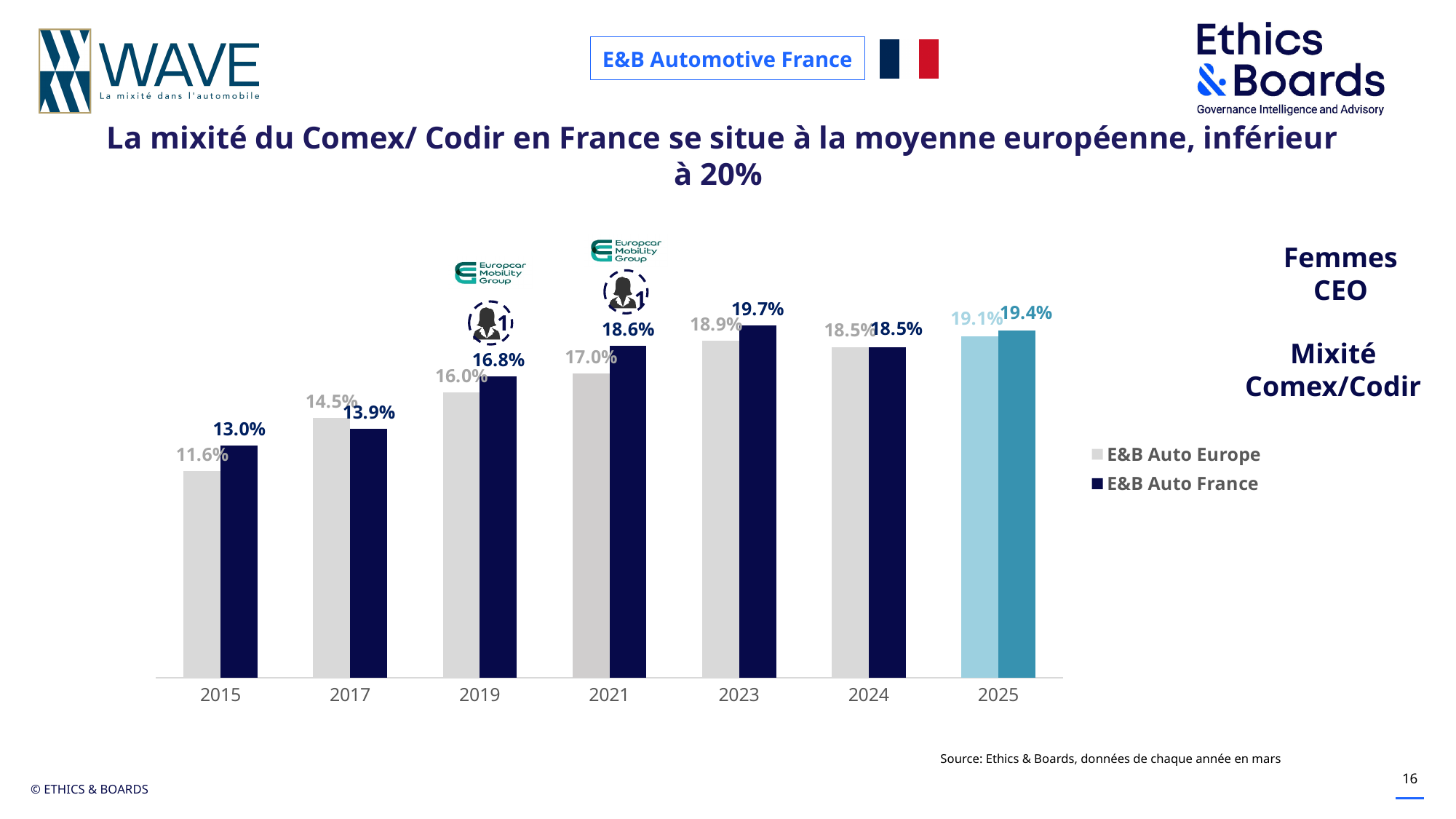
In which year is the E&B Auto France value highest? 2023 What is the E&B Auto France value for 2015? 13.0% What is the difference between the E&B Auto France and E&B Auto Europe values in 2021? 1.6% Does the E&B Auto Europe value rise or fall from 2015 to 2025? Rise What is the E&B Auto Europe value for 2025? 19.1% What kind of chart is shown on the slide? Bar chart In which year is the E&B Auto Europe value lowest? 2015 How many series does the legend list? 2 What is the E&B Auto France value for 2023? 19.7% Which is larger in 2017: the E&B Auto Europe value or the E&B Auto France value? E&B Auto Europe How many years are shown on the x axis? 7 What is the E&B Auto Europe value for 2019? 16.0%